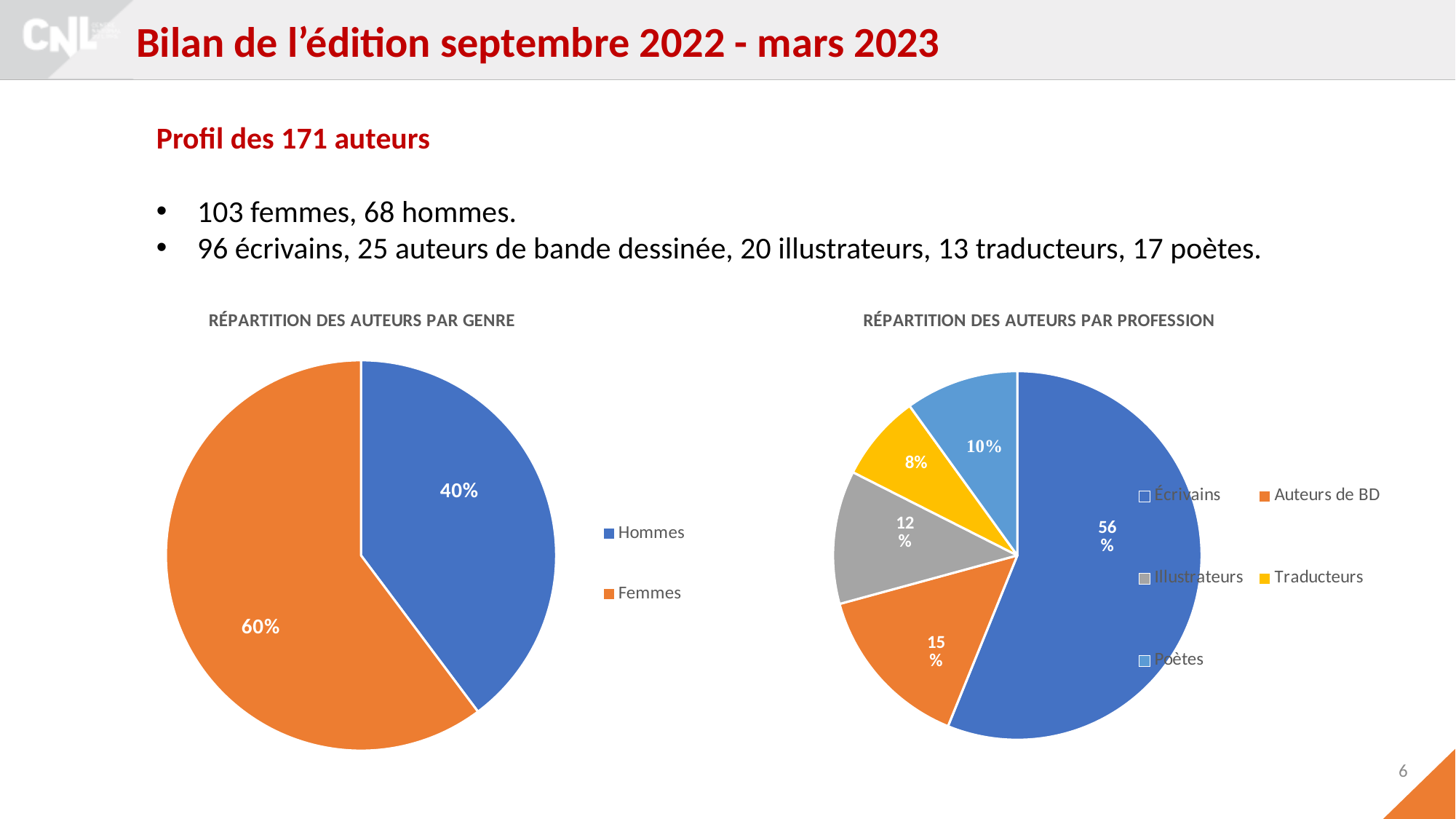
In the chart titled 'RÉPARTITION DES AUTEURS PAR GENRE', what share of the pie is Hommes? 40% In the chart titled 'RÉPARTITION DES AUTEURS PAR PROFESSION', what share of the pie is Auteurs de BD? 15% In the chart titled 'RÉPARTITION DES AUTEURS PAR PROFESSION', what share of the pie is Traducteurs? 8% In the chart titled 'RÉPARTITION DES AUTEURS PAR GENRE', which category has the larger slice? Femmes In the chart titled 'RÉPARTITION DES AUTEURS PAR PROFESSION', how many categories does the legend list? 5 What kind of chart is the one titled 'RÉPARTITION DES AUTEURS PAR GENRE'? Pie chart In the chart titled 'RÉPARTITION DES AUTEURS PAR PROFESSION', what colour is the Traducteurs slice? Yellow In the chart titled 'RÉPARTITION DES AUTEURS PAR GENRE', what is the difference in percentage points between Femmes and Hommes? 20 In the chart titled 'RÉPARTITION DES AUTEURS PAR PROFESSION', which profession has the smallest slice? Traducteurs In the chart titled 'RÉPARTITION DES AUTEURS PAR PROFESSION', which is larger, Illustrateurs or Poètes? Illustrateurs